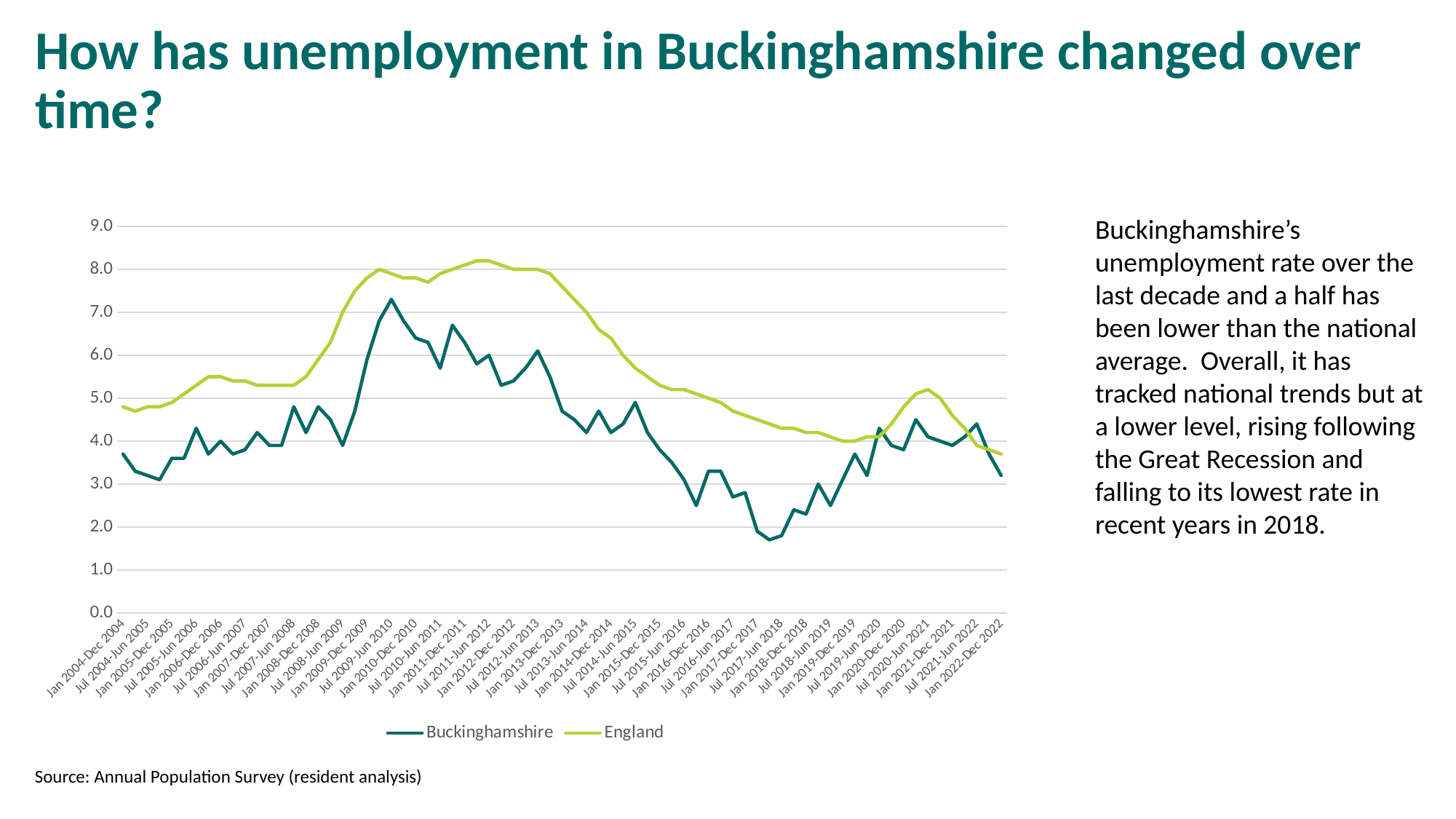
Which series is higher at Jan 2021-Dec 2021, Buckinghamshire or England? England Is the England value for Jan 2004-Dec 2004 greater or less than 5.0? less What source is cited for the chart? Annual Population Survey (resident analysis) Which series reaches the higher peak value on the chart? England What kind of chart is shown on the slide? Line chart Which series is higher at Jan 2010-Dec 2010, Buckinghamshire or England? England Is the Buckinghamshire value for Jan 2018-Dec 2018 greater or less than 2.0? greater How many series does the chart's legend list? 2 Does the Buckinghamshire line rise or fall between Jan 2010-Dec 2010 and Jan 2018-Dec 2018? Fall Is the Buckinghamshire value for Jan 2010-Dec 2010 greater or less than 7.0? less What are the two series named in the chart's legend? Buckinghamshire and England